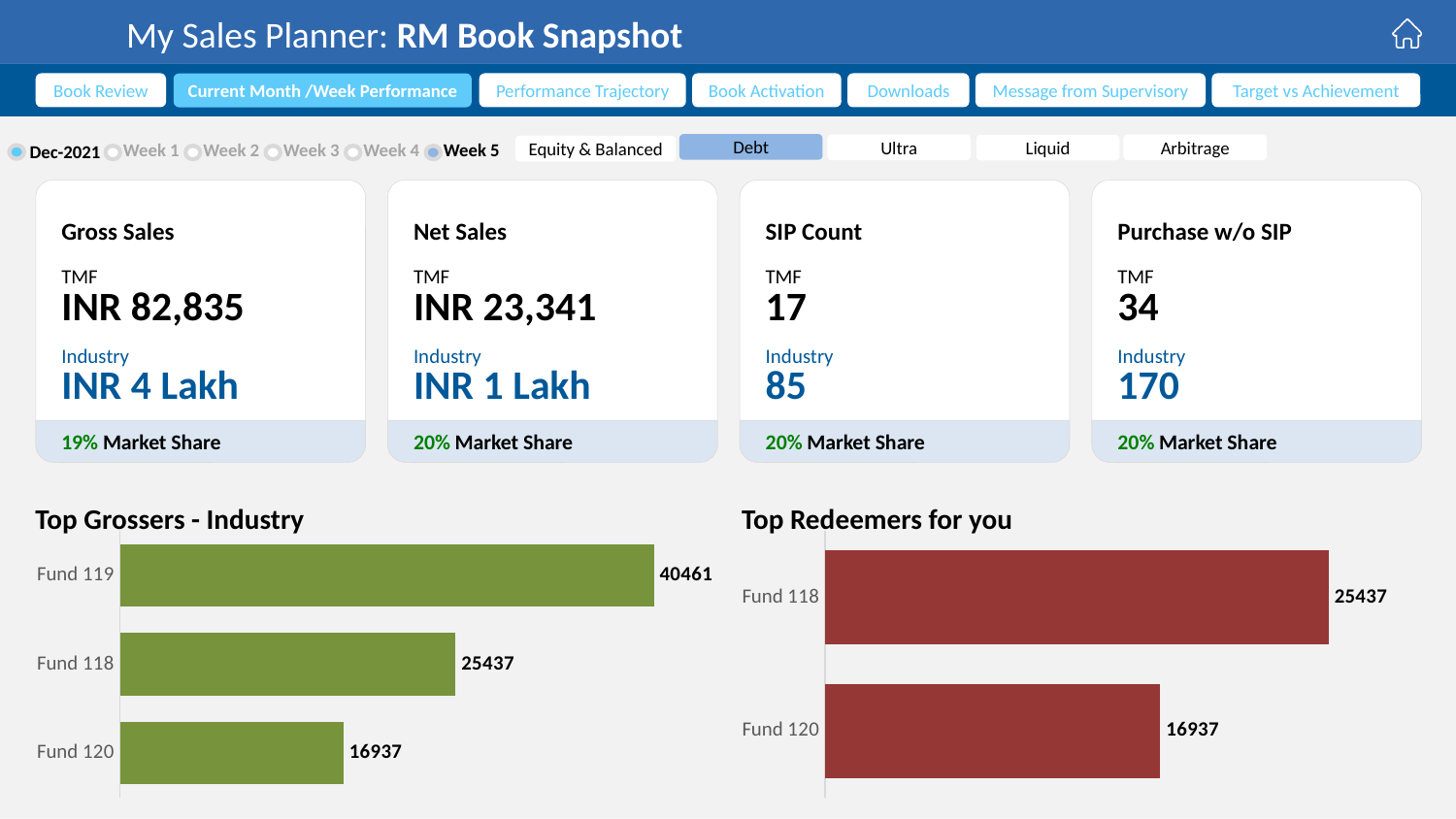
In the 'Top Redeemers for you' chart, what is the difference between the values for Fund 118 and Fund 120? 8500 What type of chart is 'Top Grossers - Industry'? Bar chart In the 'Top Redeemers for you' chart, which fund has the higher value, Fund 118 or Fund 120? Fund 118 In the 'Top Grossers - Industry' chart, what is the value for Fund 120? 16937 What colour are the bars in the 'Top Redeemers for you' chart? Dark red In the 'Top Redeemers for you' chart, what is the value for Fund 118? 25437 In the 'Top Grossers - Industry' chart, which fund has the lowest value? Fund 120 In the 'Top Grossers - Industry' chart, what is the value for Fund 119? 40461 In the 'Top Grossers - Industry' chart, how many funds are shown? 3 In the 'Top Redeemers for you' chart, how many funds are shown? 2 In the 'Top Grossers - Industry' chart, which fund has the highest value? Fund 119 In the 'Top Grossers - Industry' chart, what is the difference between the values for Fund 119 and Fund 118? 15024